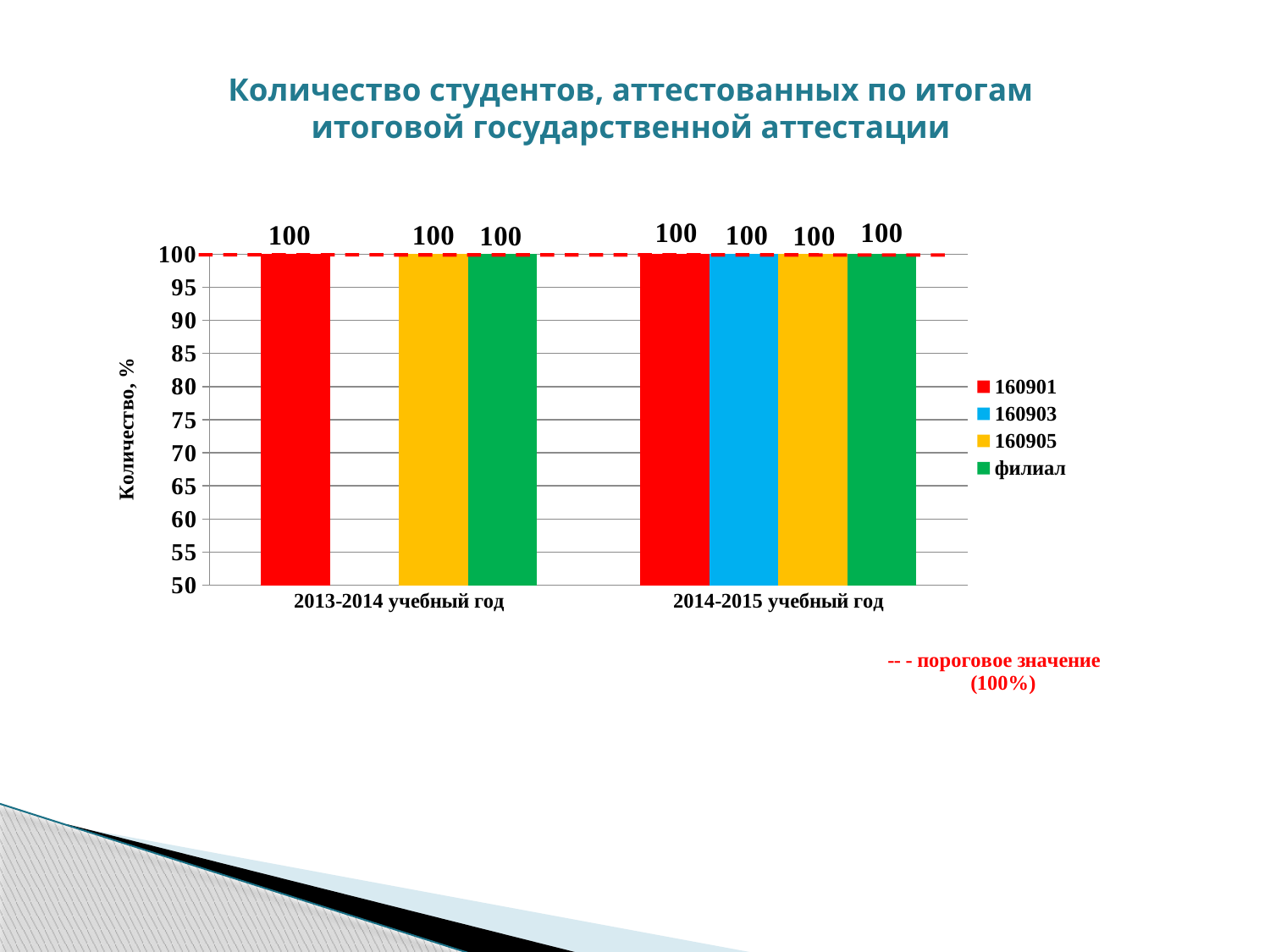
What is the difference between the value for 160901 in 2013-2014 учебный год and the value for 160901 in 2014-2015 учебный год? 0 What is the label of the y axis? Количество, % How many categories are shown on the x axis? 2 What value does the red dashed line (пороговое значение) mark? 100% What is the value for филиал in 2014-2015 учебный год? 100 What is the value for 160903 in 2014-2015 учебный год? 100 What kind of chart is shown on the slide? bar chart What is the value for 160901 in 2013-2014 учебный год? 100 How many bars are plotted for 2013-2014 учебный год? 3 Does the value for филиал rise, fall or stay the same from 2013-2014 учебный год to 2014-2015 учебный год? stays the same What is the value for 160905 in 2013-2014 учебный год? 100 How many series does the legend list? 4